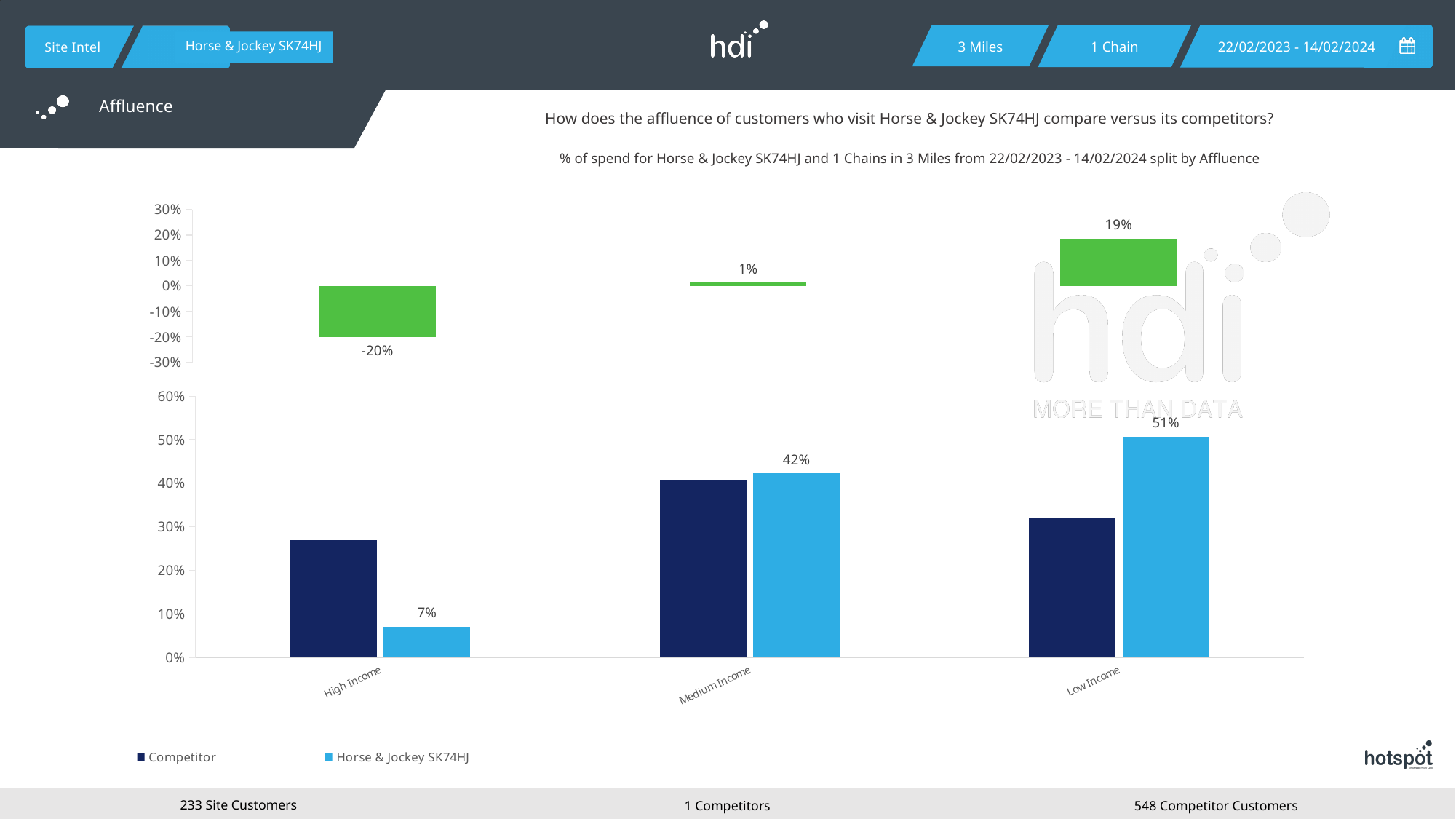
In the bottom chart, which category has the lowest value for Horse & Jockey SK74HJ? High Income In the bottom chart, what is the value for Horse & Jockey SK74HJ in the High Income category? 7% In the bottom chart, what is the value for Horse & Jockey SK74HJ in the Low Income category? 51% In the bottom chart, what is the difference between the Horse & Jockey SK74HJ values for Low Income and High Income? 44% In the bottom chart, in the High Income category, which series has the larger value, Competitor or Horse & Jockey SK74HJ? Competitor What kind of chart is the bottom chart? Bar chart How many series does the legend of the bottom chart list? 2 In the top chart, what is the value shown for the Low Income category? 19% In the bottom chart, what is the value for Horse & Jockey SK74HJ in the Medium Income category? 42% In the bottom chart, which category has the highest value for Horse & Jockey SK74HJ? Low Income In the top chart, what is the value shown for the High Income category? -20% In the bottom chart, is the Competitor value for High Income greater or less than 20%? greater